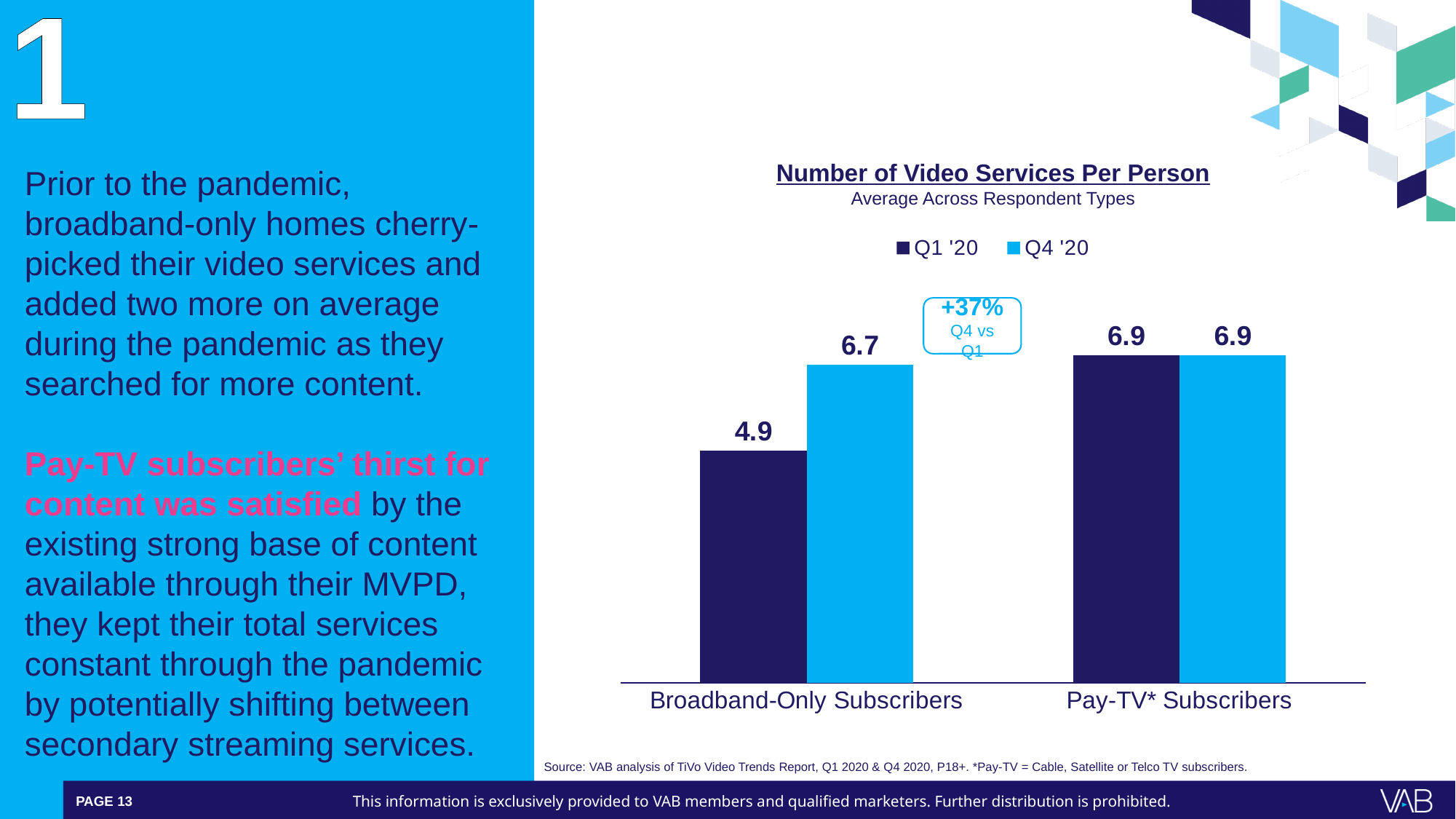
Which category has the highest Q4 '20 value? Pay-TV* Subscribers What is the difference between the Q4 '20 and Q1 '20 values for Broadband-Only Subscribers? 1.8 What is the Q1 '20 value for Broadband-Only Subscribers? 4.9 How many series does the legend list? 2 What is the title of the chart? Number of Video Services Per Person How many categories are shown on the x axis? 2 What kind of chart is shown on the slide? Bar chart What is the Q4 '20 value for Broadband-Only Subscribers? 6.7 Which is larger for Broadband-Only Subscribers, the Q1 '20 value or the Q4 '20 value? Q4 '20 What is the Q4 '20 value for Pay-TV* Subscribers? 6.9 Which category has the lowest Q1 '20 value? Broadband-Only Subscribers What is the Q1 '20 value for Pay-TV* Subscribers? 6.9